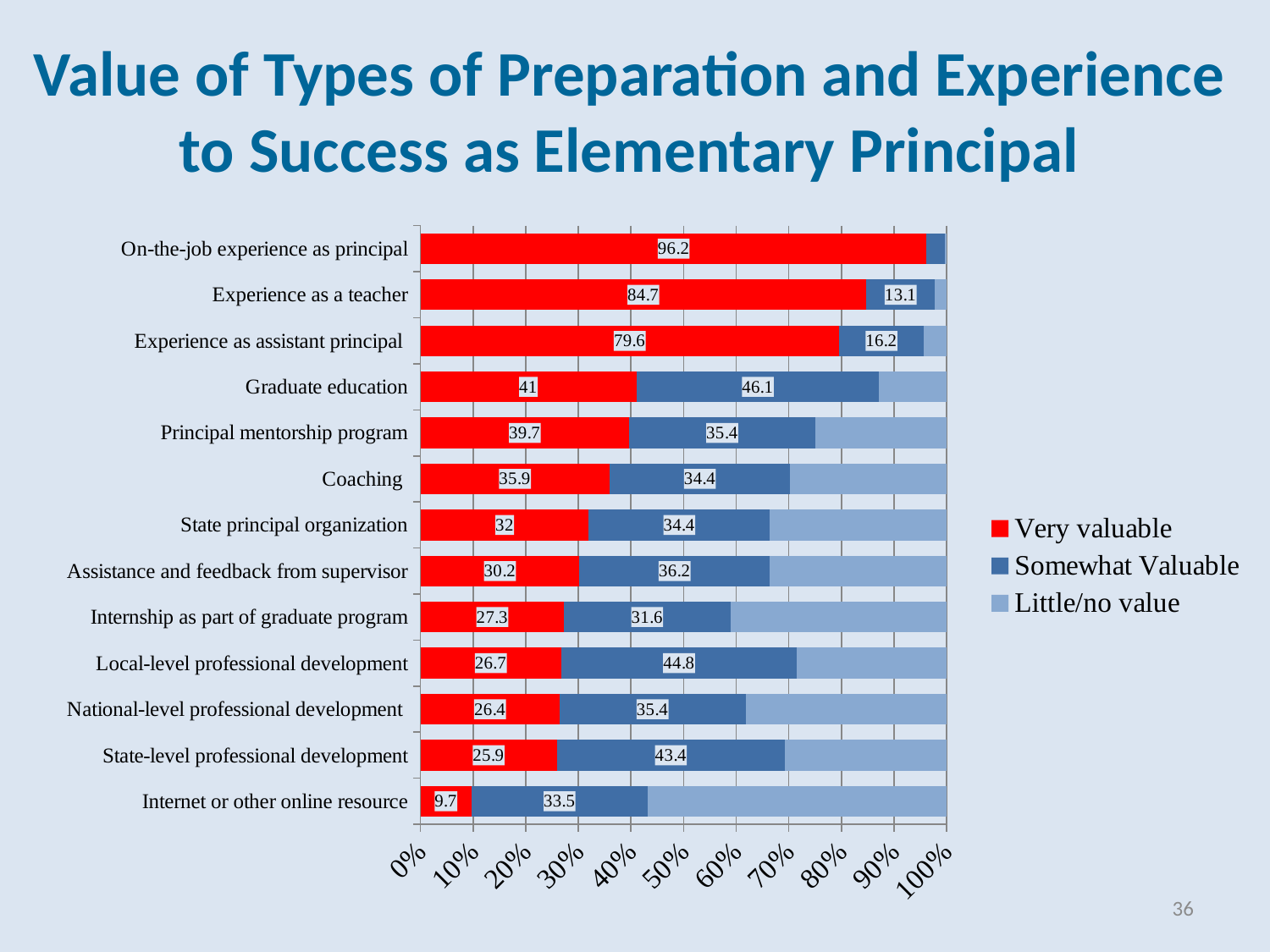
What is the difference between the Very valuable values for Experience as a teacher and Experience as assistant principal? 5.1 Is the Little/no value segment for Internet or other online resource greater or less than 40%? greater Which category has the highest Very valuable value? On-the-job experience as principal How many categories are shown on the chart? 13 What is the Very valuable value for Internet or other online resource? 9.7 What is the Somewhat Valuable value for Graduate education? 46.1 What is the Very valuable value for Experience as a teacher? 84.7 What is the Somewhat Valuable value for Local-level professional development? 44.8 Which category has the lowest Very valuable value? Internet or other online resource What kind of chart is shown on the slide? Stacked bar chart How many series does the legend list? 3 Which has a larger Very valuable value, Coaching or State principal organization? Coaching